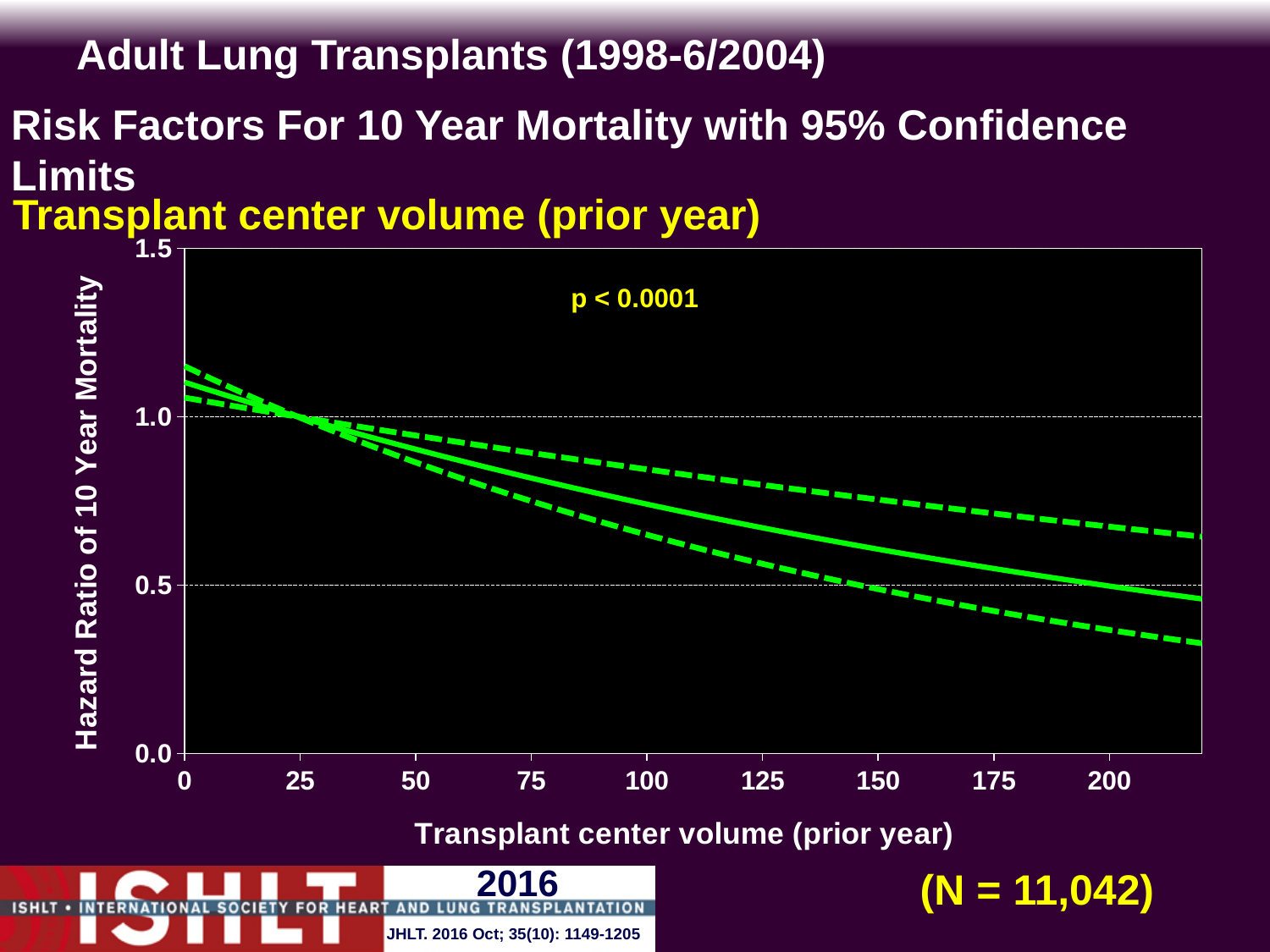
Is the hazard ratio on the solid line at a transplant center volume of 100 greater or less than 0.5? greater Is the hazard ratio on the solid line at a transplant center volume of 50 greater or less than 1.0? less Is the lower dashed confidence limit at a transplant center volume of 200 greater or less than 0.5? less How many lines are plotted on the chart? 3 What p-value is printed on the chart? p < 0.0001 What kind of chart is shown on the slide? line chart What is the label of the y axis of the chart? Hazard Ratio of 10 Year Mortality Does the hazard ratio of 10 year mortality rise or fall as transplant center volume (prior year) increases? fall